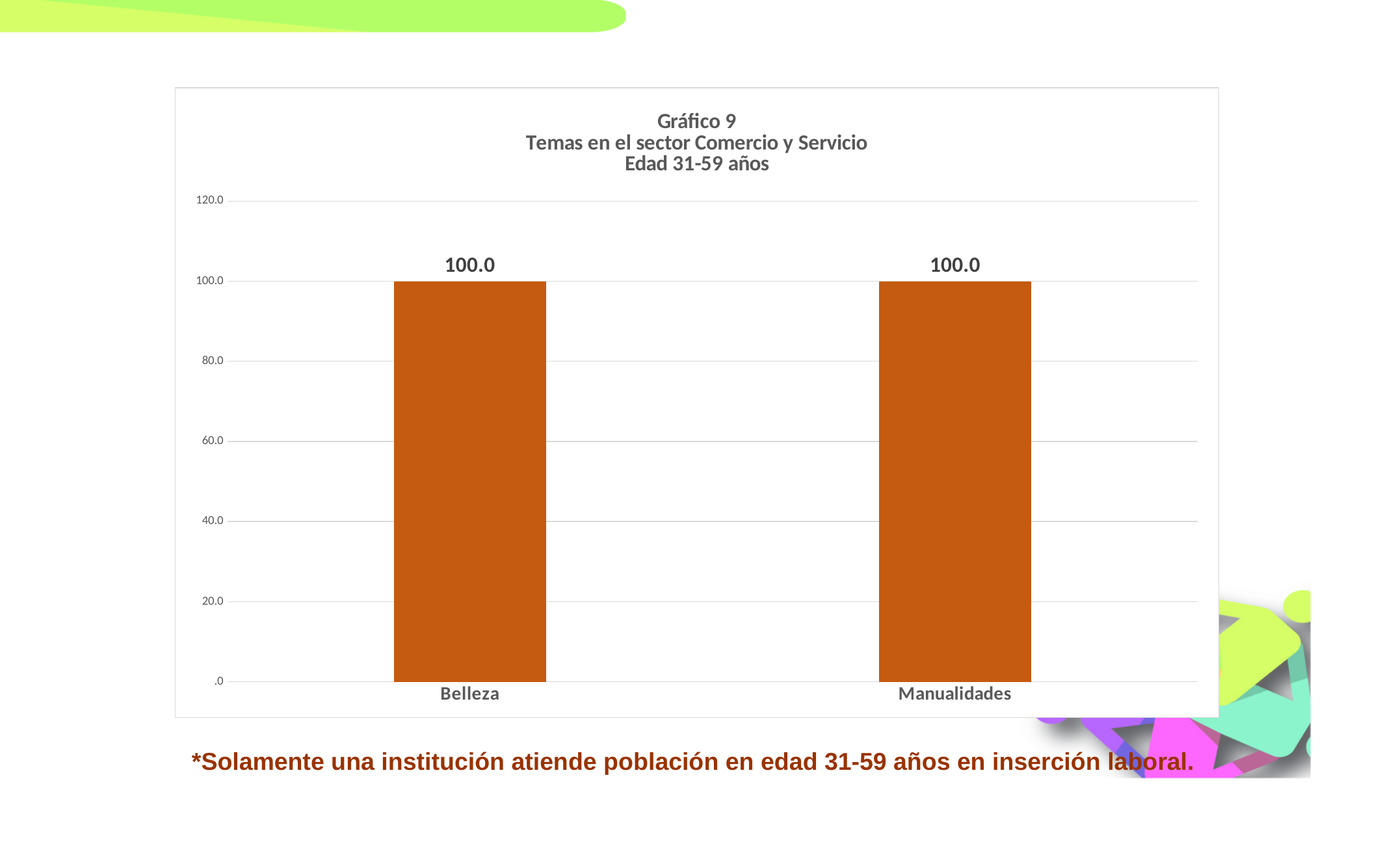
What is the difference between the values for Belleza and Manualidades? 0.0 What kind of chart is shown on the slide? bar chart What colour are the bars in the chart? orange Do the values rise, fall or stay the same from Belleza to Manualidades? stay the same What is the title of the chart? Gráfico 9 Temas en el sector Comercio y Servicio Edad 31-59 años Is the value for Manualidades greater or less than 120.0? less What is the value for Manualidades? 100.0 What is the highest value shown on the y axis? 120.0 What is the value for Belleza? 100.0 Is the value for Belleza greater or less than 80.0? greater How many categories are shown on the x axis? 2